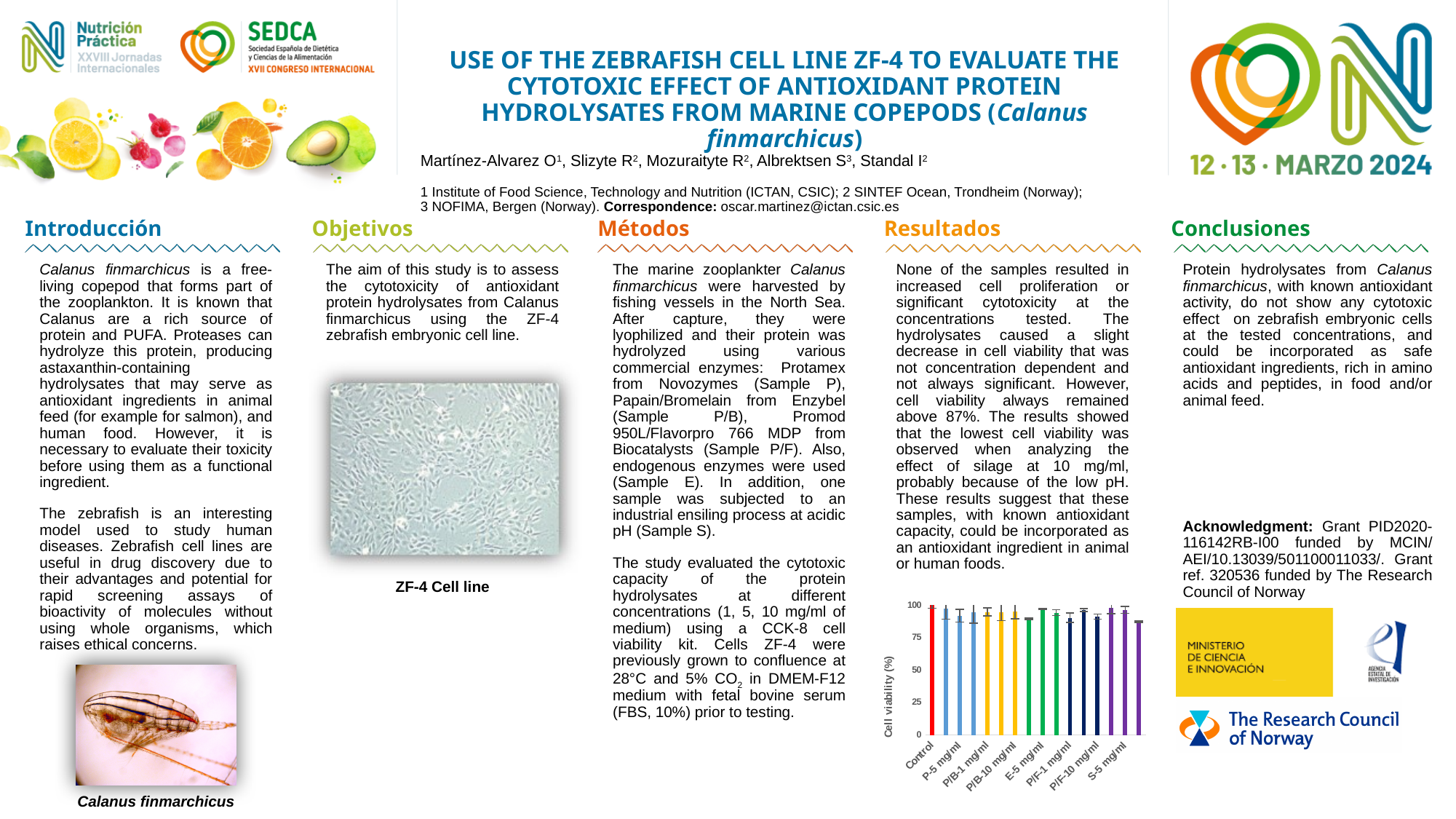
What kind of chart is shown in the Resultados section? bar chart In the Resultados bar chart, is the value for P/F-10 mg/ml greater or less than 25? greater In the Resultados bar chart, is the value for P-5 mg/ml greater or less than 50? greater What is the highest tick value shown on the y axis of the Resultados bar chart? 100 In the Resultados bar chart, is the value for Control greater or less than 75? greater What is the label of the y axis of the bar chart in the Resultados section? Cell viability (%)